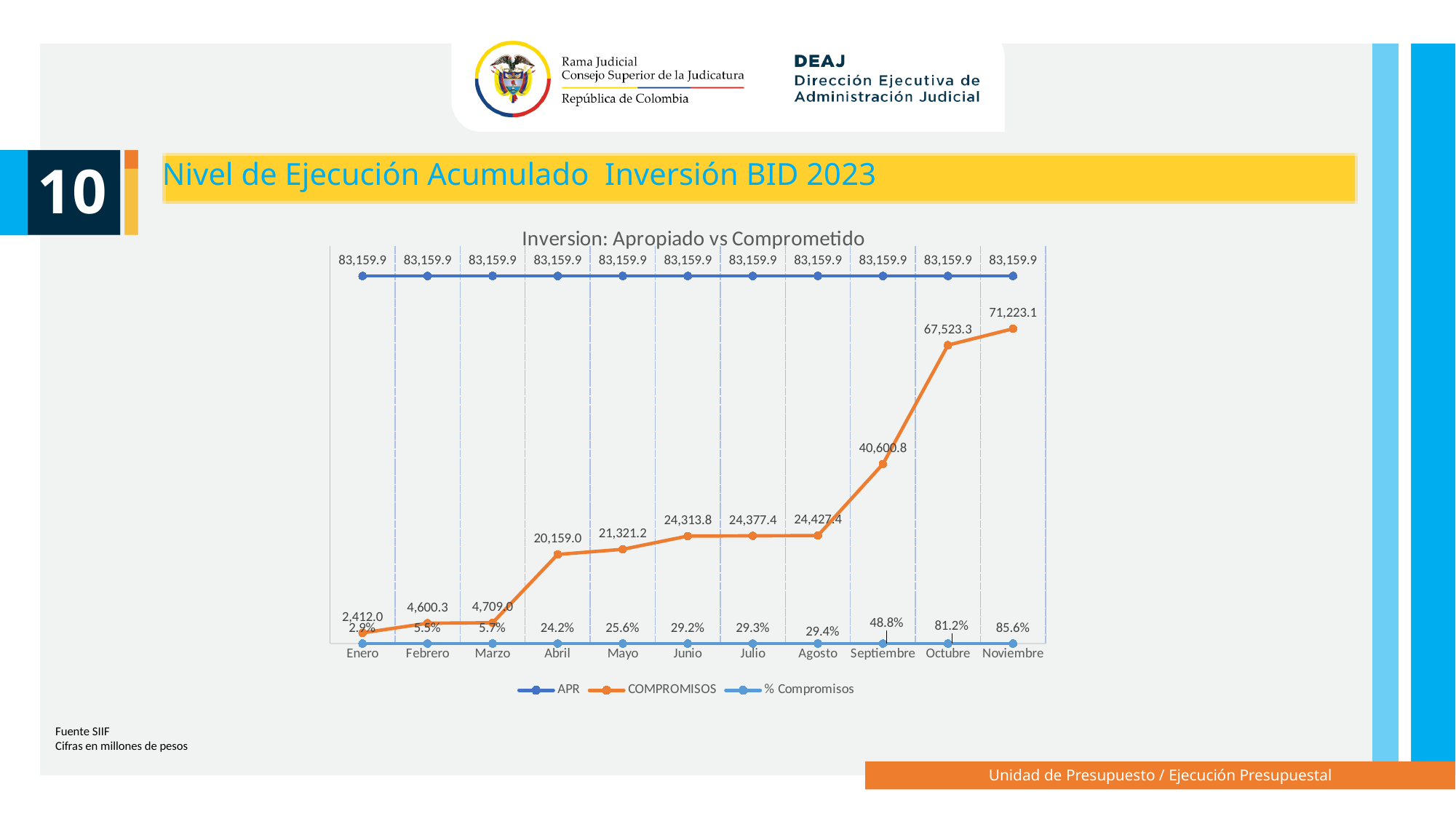
What is the difference between the COMPROMISOS values for Noviembre and Octubre? 3,699.8 What kind of chart is shown on the slide? Line chart Does the COMPROMISOS series rise or fall from Enero to Noviembre? Rise What is the % Compromisos value for Septiembre? 48.8% How many series does the chart legend list? 3 What is the APR value for Junio? 83,159.9 What is the COMPROMISOS value for Abril? 20,159.0 In which month is the COMPROMISOS value lowest? Enero Which is larger, the COMPROMISOS value for Septiembre or for Agosto? Septiembre In which month is the COMPROMISOS value highest? Noviembre What is the title of the chart? Inversion: Apropiado vs Comprometido How many months are plotted along the x axis of the chart? 11